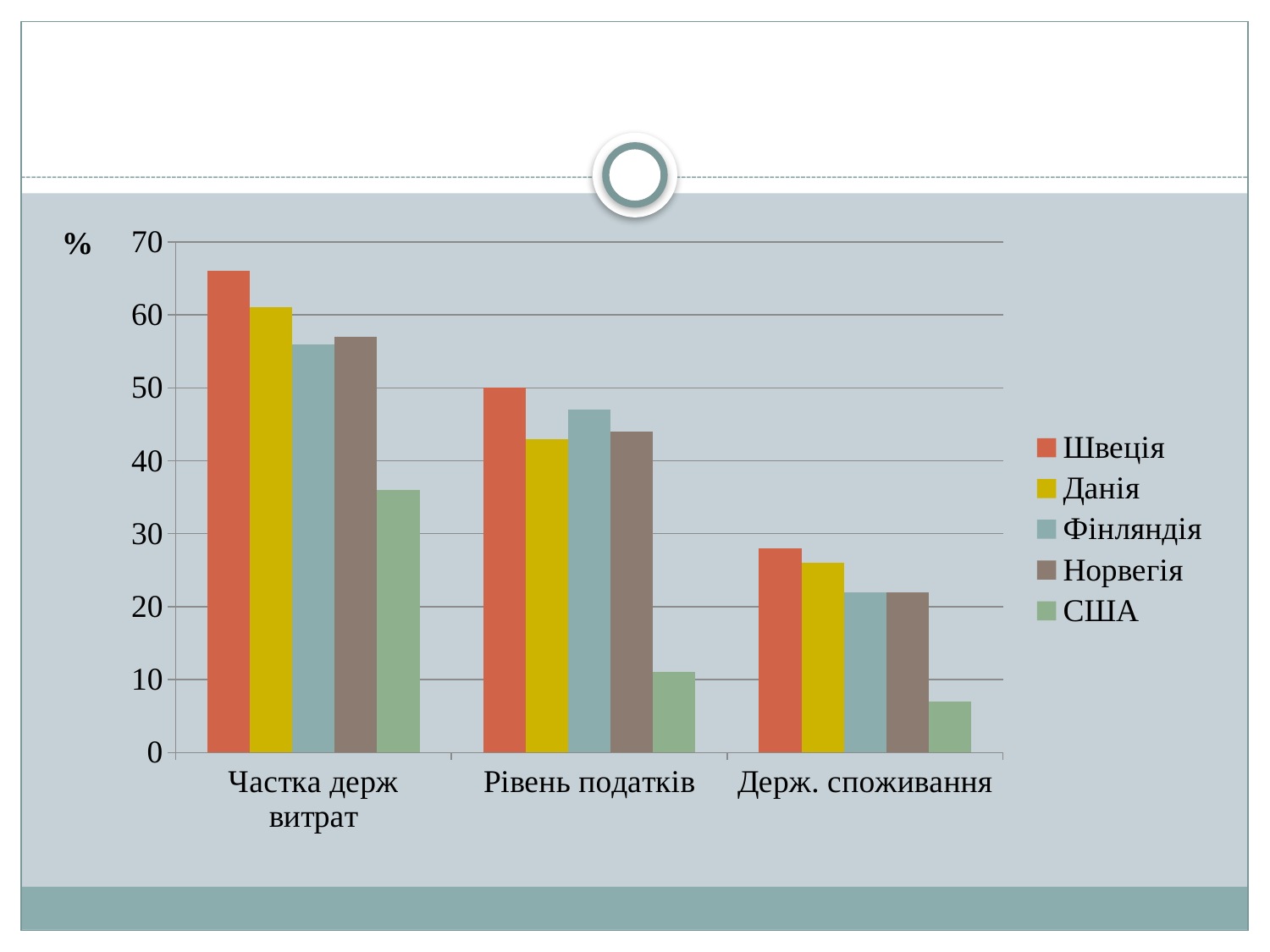
Is the value for США in Держ. споживання greater or less than 10? less Is the value for США in Частка держ витрат greater or less than 40? less How many series does the chart's legend list? 5 Do the values for Швеція rise or fall from Частка держ витрат to Держ. споживання along the x axis? fall What kind of chart is shown on the slide? bar chart How many categories are shown on the x axis of the chart? 3 Which country has the lowest value for Рівень податків? США In the Рівень податків category, which is larger: the value for Фінляндія or the value for Данія? Фінляндія Which country has the lowest value for Держ. споживання? США What is the value for Швеція in the Рівень податків category? 50 Which country has the highest value for Частка держ витрат? Швеція